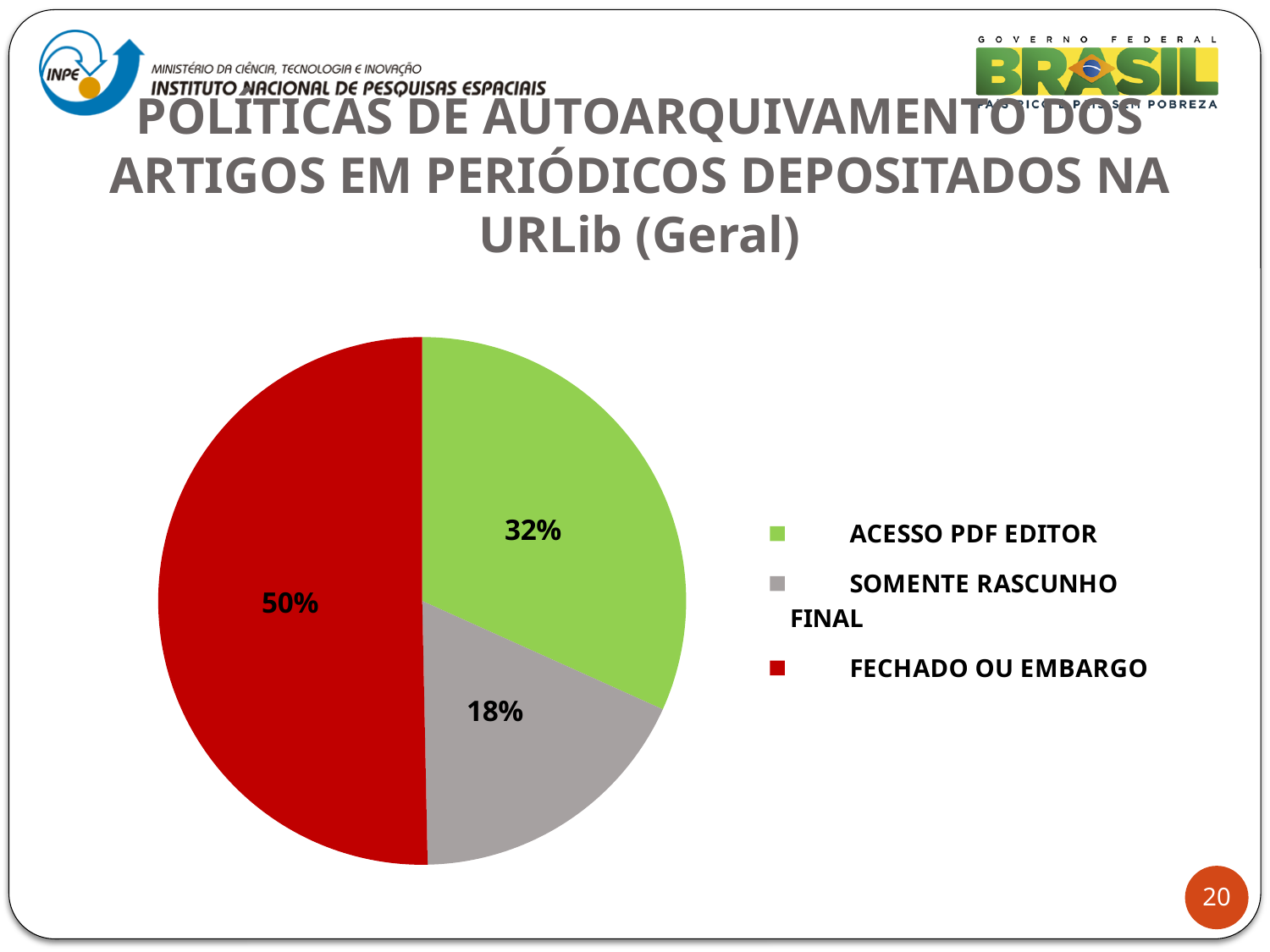
What kind of chart is shown on the slide? pie chart How many slices does the pie chart have? 3 Which category is shown in grey in the legend? SOMENTE RASCUNHO FINAL Which is larger, the slice for ACESSO PDF EDITOR or the slice for SOMENTE RASCUNHO FINAL? ACESSO PDF EDITOR What colour is the slice for FECHADO OU EMBARGO? red What is the difference in percentage points between ACESSO PDF EDITOR and SOMENTE RASCUNHO FINAL? 14 What share of the pie does FECHADO OU EMBARGO represent? 50% Which category has the smallest slice of the pie? SOMENTE RASCUNHO FINAL What share of the pie does SOMENTE RASCUNHO FINAL represent? 18% Which category has the largest slice of the pie? FECHADO OU EMBARGO What is the difference in percentage points between FECHADO OU EMBARGO and ACESSO PDF EDITOR? 18 What share of the pie does ACESSO PDF EDITOR represent? 32%